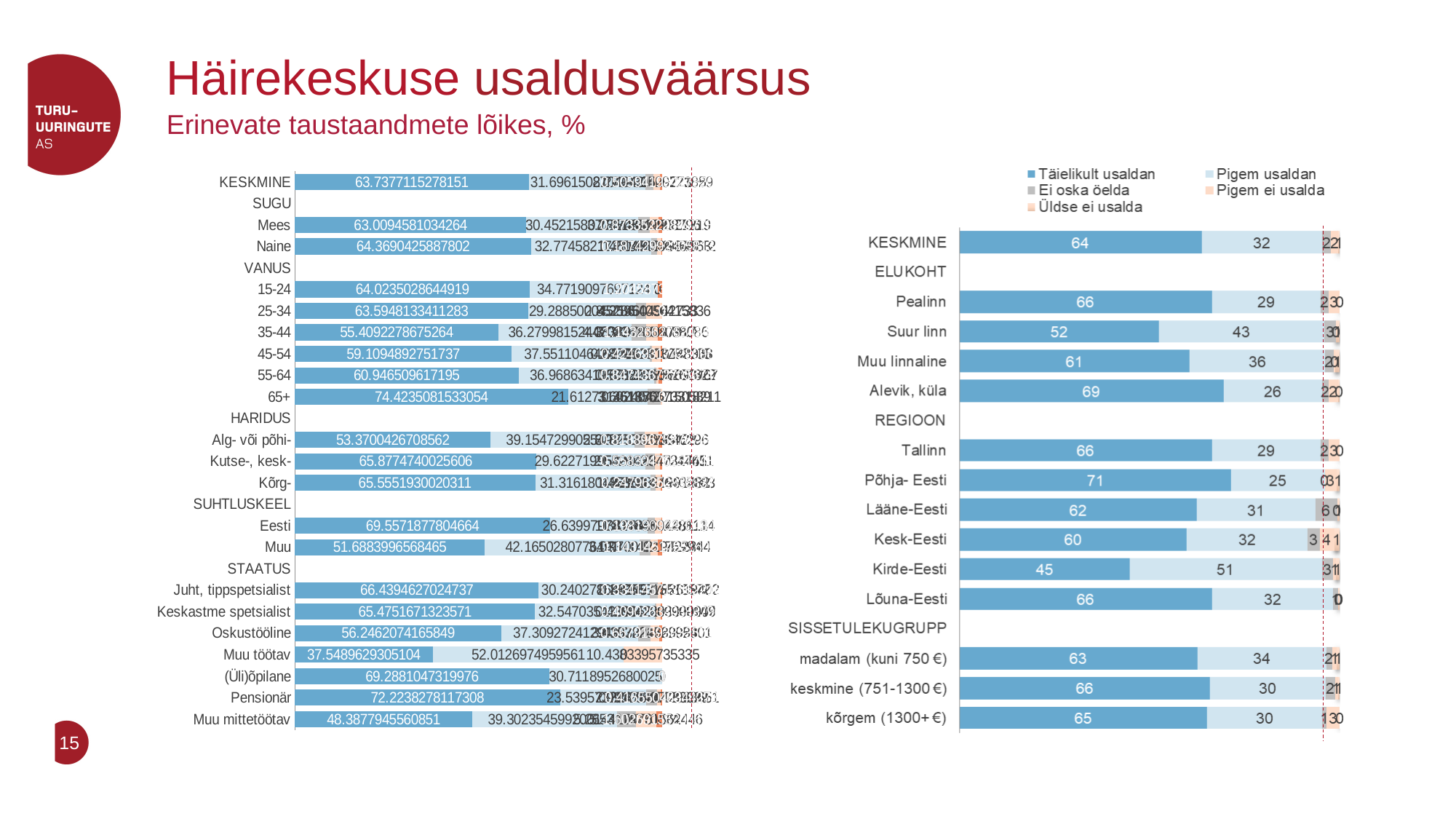
In the left chart, which category has the lowest 'Täielikult usaldan' value? Muu töötav What kind of chart is the chart on the right? Stacked bar chart In the right chart, which category has the lowest 'Täielikult usaldan' value? Kirde-Eesti Which series is shown in dark blue in the legend? Täielikult usaldan In the right chart, which has the larger 'Pigem usaldan' value: Kirde-Eesti or Pealinn? Kirde-Eesti In the right chart, what is the 'Täielikult usaldan' value for Kirde-Eesti? 45 In the left chart, what is the 'Täielikult usaldan' value for 'Muu' under SUHTLUSKEEL? 51.6883996568465 In the left chart, what is the 'Täielikult usaldan' value for the 65+ age group? 74.4235081533054 In the right chart, what is the 'Pigem usaldan' value for Suur linn? 43 In the right chart, what is the difference between the 'Täielikult usaldan' values for 'Alevik, küla' and 'Suur linn'? 17 How many series does the legend on the right list? 5 In the right chart, which category has the highest 'Täielikult usaldan' value? Põhja- Eesti